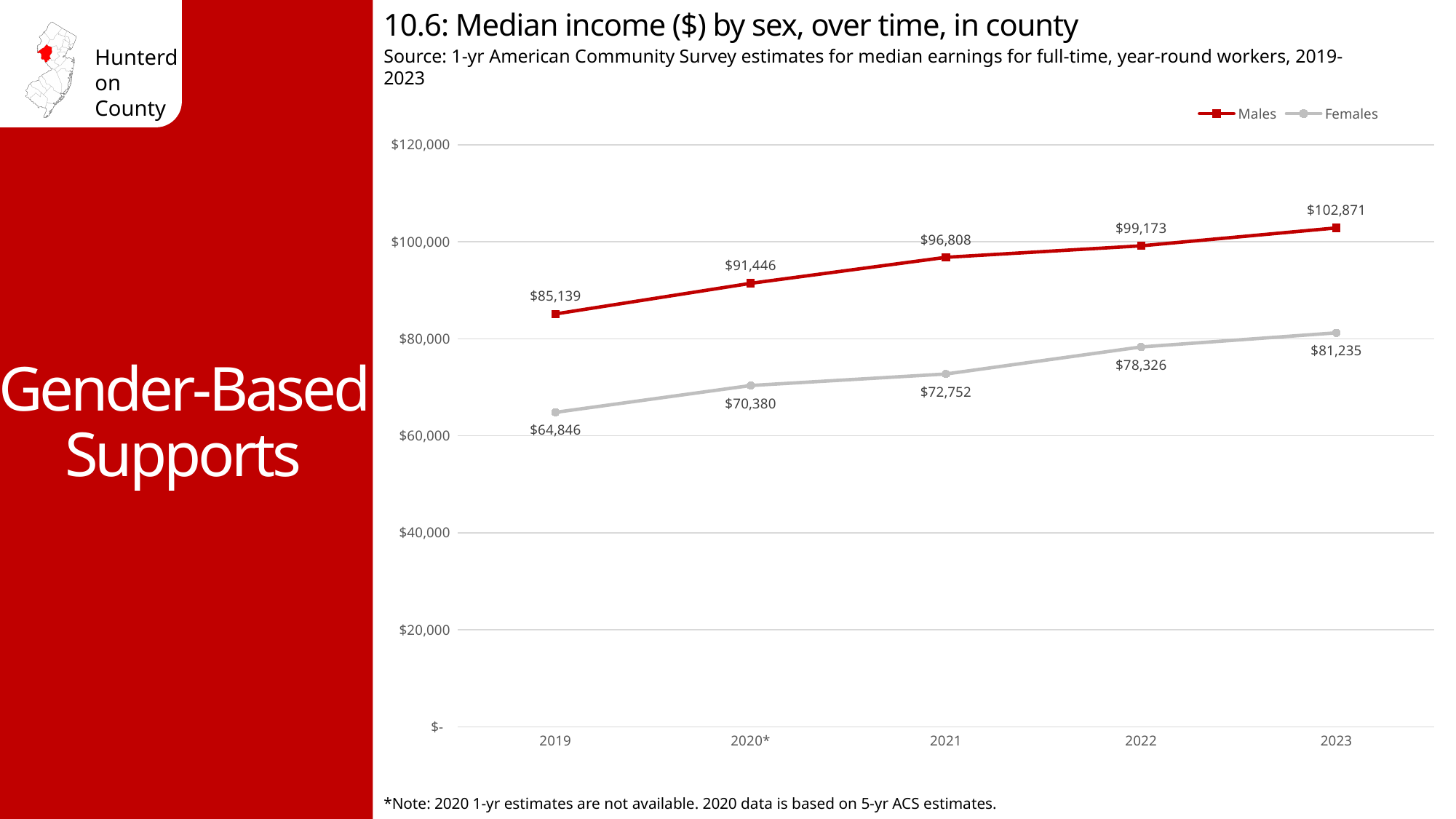
In which year is the Males median income highest? 2023 What is the median income for Females in 2019? $64,846 Does the Females median income rise or fall from 2019 to 2023? rise What is the median income for Males in 2023? $102,871 What is the difference between the Males and Females median income in 2023? $21,636 What is the median income for Males in 2020*? $91,446 In which year is the Females median income lowest? 2019 How many years are shown on the x axis? 5 What is the difference between the Males and Females median income in 2019? $20,293 How many series does the legend list? 2 What is the median income for Females in 2021? $72,752 Which is larger in 2022, the Males median income or the Females median income? Males